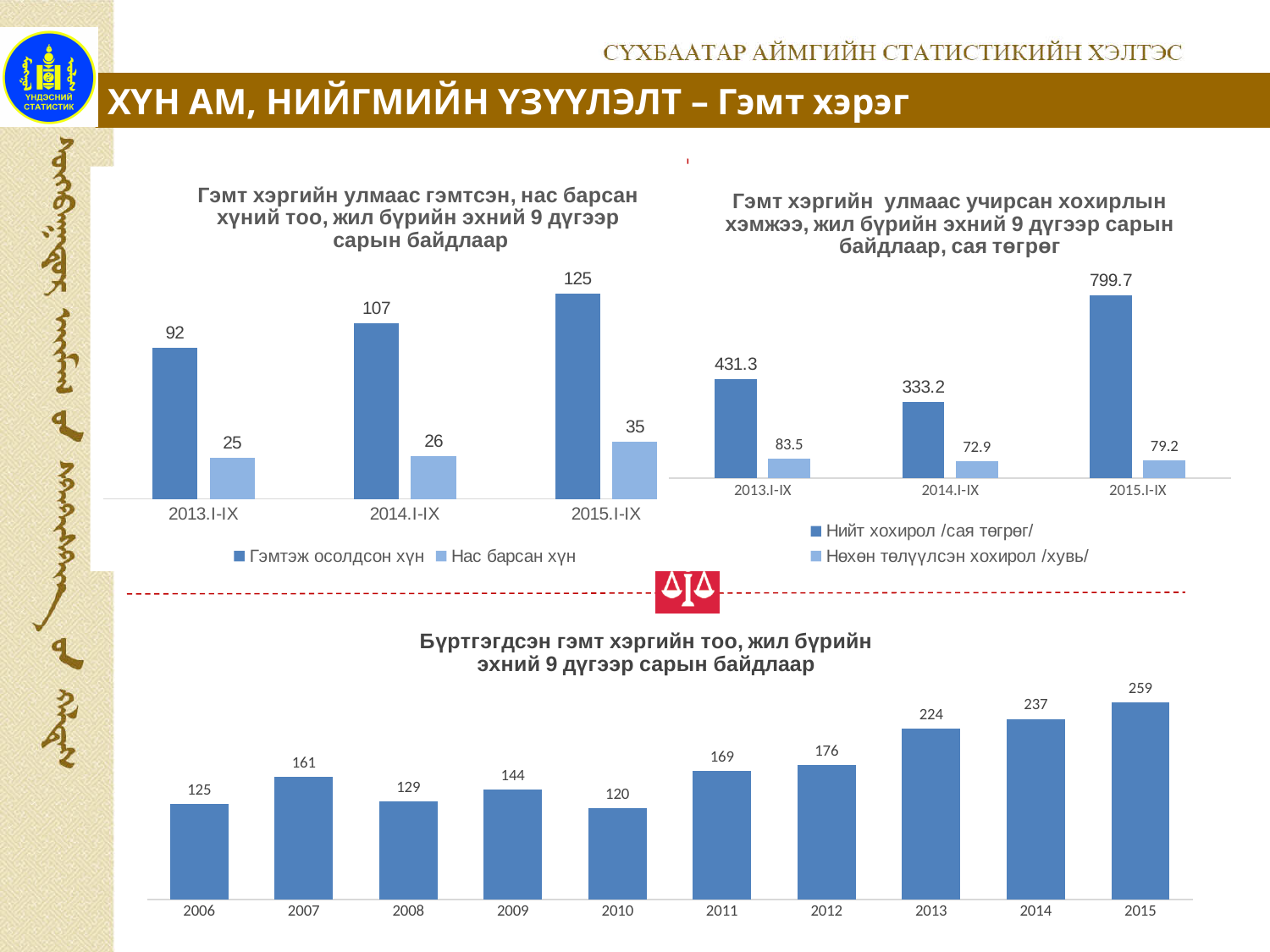
In the top-right chart, what is the value for Нийт хохирол /сая төгрөг/ in 2015.I-IX? 799.7 In the bottom chart, what is the difference between the values for 2015 and 2006? 134 In the bottom chart, how many years are shown on the x axis? 10 In the top-left chart, what is the value for Гэмтэж осолдсон хүн in 2015.I-IX? 125 How many series does the legend of the top-left chart list? 2 In the top-left chart, what is the value for Нас барсан хүн in 2013.I-IX? 25 In the top-left chart, what is the difference between Гэмтэж осолдсон хүн and Нас барсан хүн in 2014.I-IX? 81 In the top-right chart, which period has the lowest value for Нийт хохирол /сая төгрөг/? 2014.I-IX What kind of chart is the bottom chart? bar chart In the bottom chart, which year has the highest value? 2015 In the bottom chart, what is the value for 2010? 120 In the top-right chart, what is the value for Нөхөн төлүүлсэн хохирол /хувь/ in 2014.I-IX? 72.9